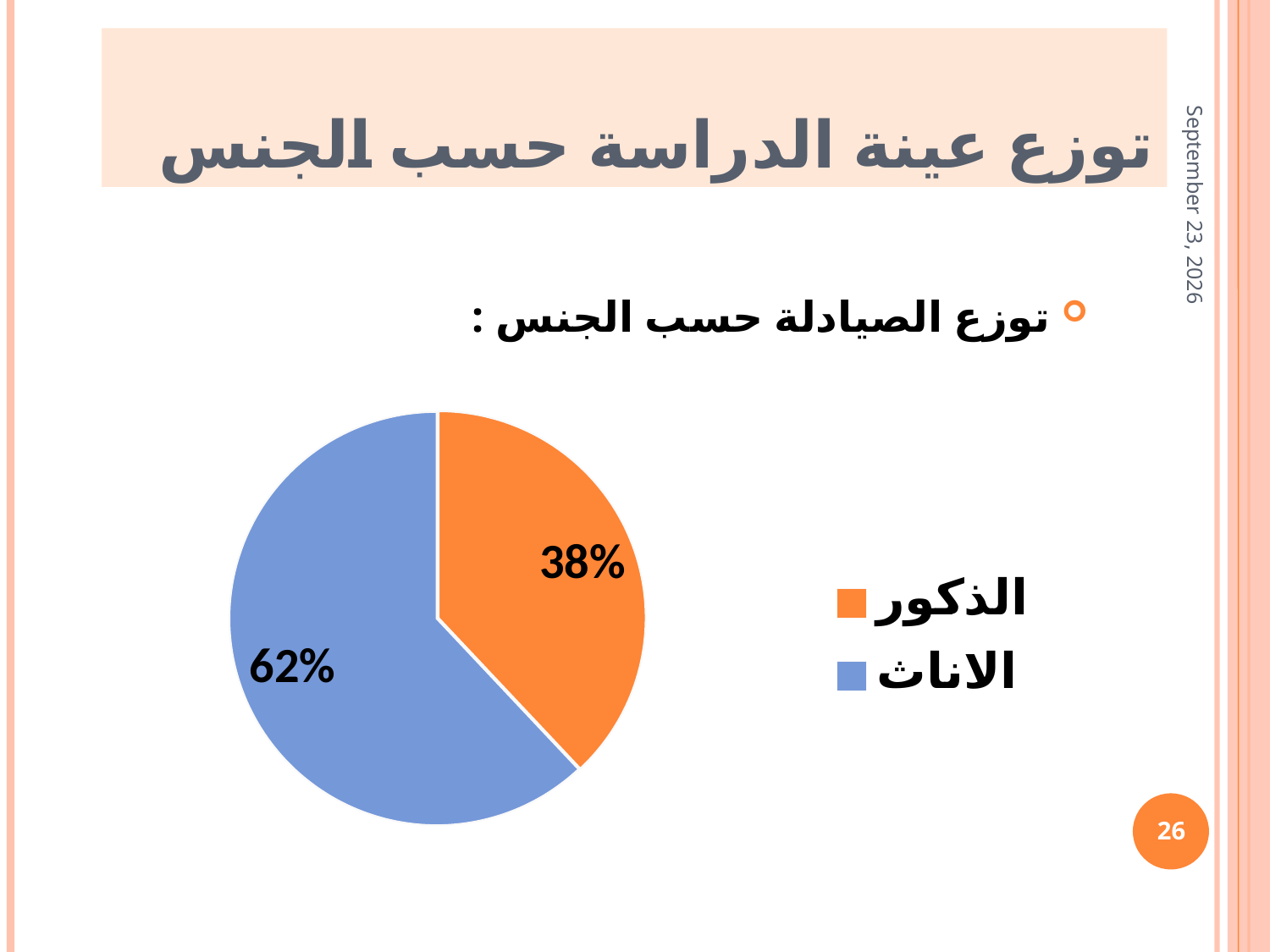
Is the share for الاناث greater or less than 50%? greater How many slices does the pie chart have? 2 What kind of chart is shown on the slide? pie chart What share of the pie chart is labelled الذكور (males)? 38% Which category has the smallest slice in the pie chart? الذكور What is the difference in percentage points between the الاناث slice and the الذكور slice? 24 What colour is the الاناث slice in the pie chart? blue What colour is the الذكور slice in the pie chart? orange What share of the pie chart is labelled الاناث (females)? 62% How many entries does the legend list? 2 Which slice is larger, الذكور or الاناث? الاناث Which category has the largest slice in the pie chart? الاناث